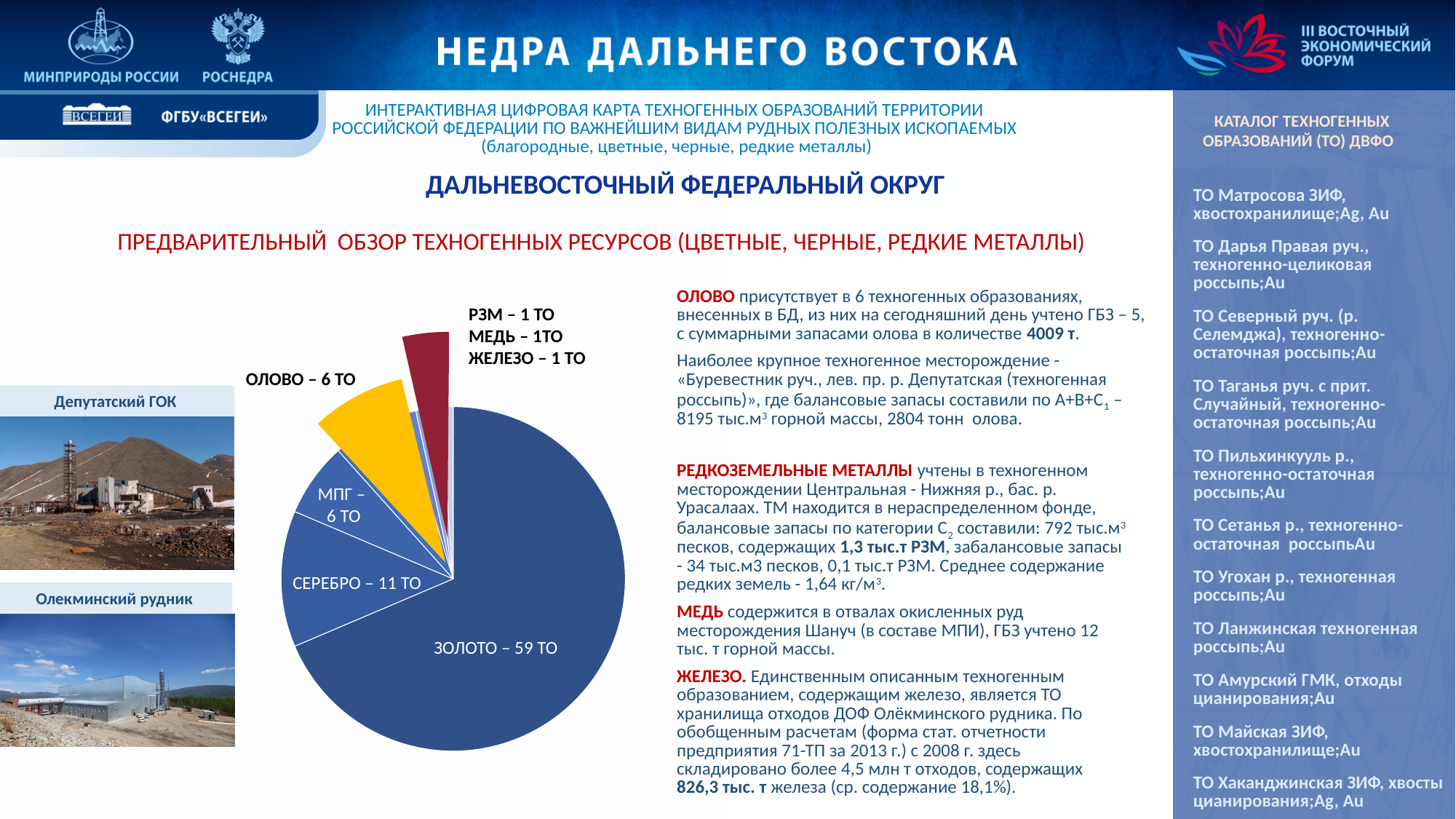
Which is larger, the value for СЕРЕБРО or the value for ОЛОВО? СЕРЕБРО What is the value shown for ОЛОВО in the pie chart? 6 ТО What kind of chart is shown on the slide? pie chart What is the value shown for ЗОЛОТО in the pie chart? 59 ТО What is the value shown for СЕРЕБРО in the pie chart? 11 ТО What is the difference between the values for СЕРЕБРО and МПГ? 5 ТО What is the difference between the values for ЗОЛОТО and СЕРЕБРО? 48 ТО How many categories (slices) does the pie chart have? 8 What is the value shown for МЕДЬ in the pie chart? 1 ТО Which category has the largest slice in the pie chart? ЗОЛОТО Which categories in the pie chart have a value of 1 ТО? РЗМ, МЕДЬ, ЖЕЛЕЗО